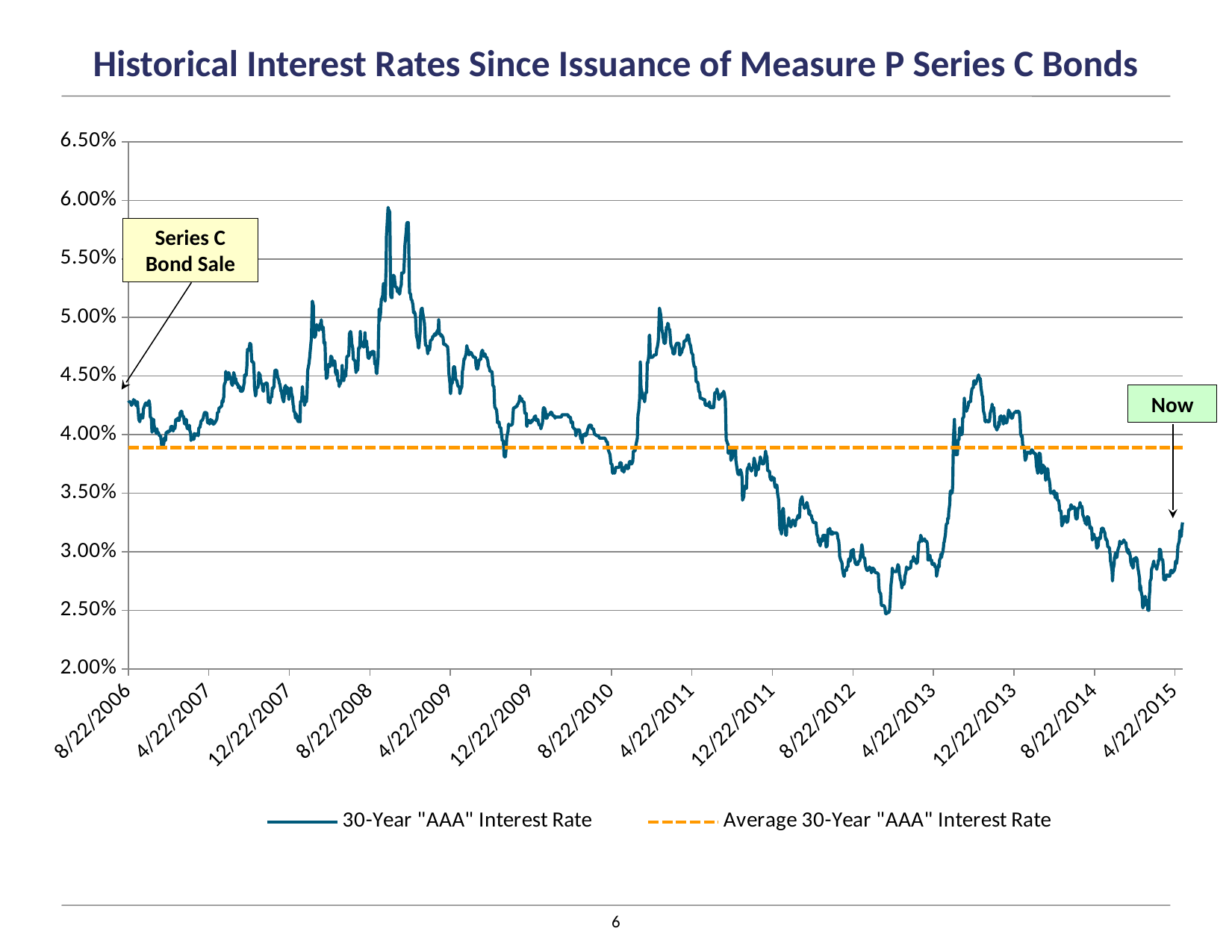
Which is higher: the 30-Year "AAA" Interest Rate at the "Series C Bond Sale" point or at the "Now" point? Series C Bond Sale Is the highest value reached by the 30-Year "AAA" Interest Rate line greater or less than 5.50%? greater How many date labels are shown on the x axis? 14 Overall, does the 30-Year "AAA" Interest Rate rise or fall from 8/22/2006 to 4/22/2015? Fall How many series does the legend list? 2 Is the 30-Year "AAA" Interest Rate at the point labelled "Now" greater or less than 3.50%? less What kind of chart is shown on the slide? Line chart Is the Average 30-Year "AAA" Interest Rate line greater or less than 3.50%? greater Which series is drawn as a dashed orange line? Average 30-Year "AAA" Interest Rate What is the title of the chart? Historical Interest Rates Since Issuance of Measure P Series C Bonds